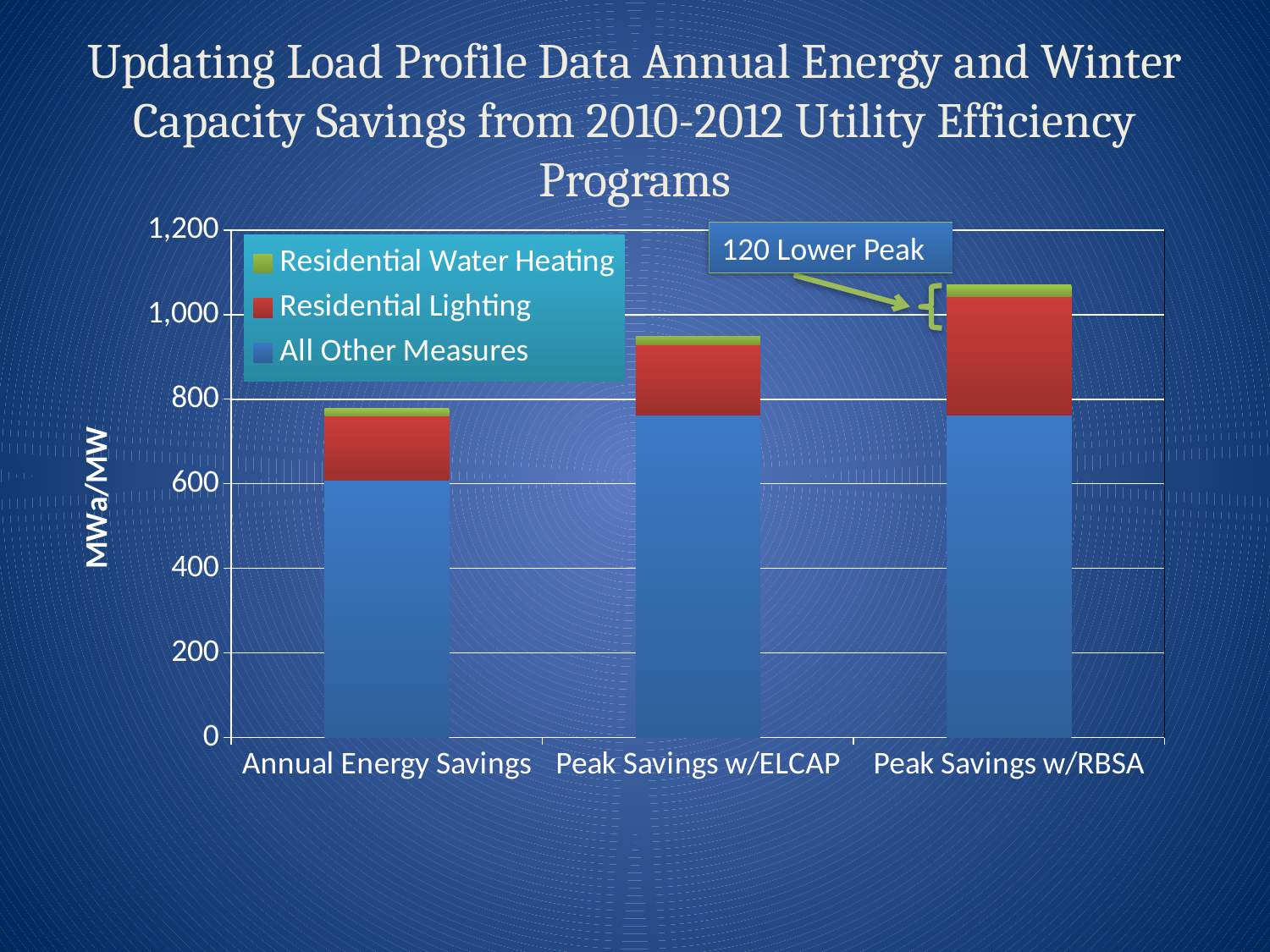
Is the total stacked value for Peak Savings w/ELCAP greater or less than 1,000? less What does the callout box above the Peak Savings w/RBSA bar say? 120 Lower Peak Is the total stacked value for Annual Energy Savings greater or less than 800? less What kind of chart is shown on the slide? Stacked bar chart Which category has the tallest stacked bar? Peak Savings w/RBSA How many series does the chart's legend list? 3 What is the label on the chart's vertical axis? MWa/MW Which category has the shortest stacked bar? Annual Energy Savings Which is larger, the total stacked bar for Peak Savings w/ELCAP or for Annual Energy Savings? Peak Savings w/ELCAP How many categories are shown on the x axis of the chart? 3 Is the total stacked value for Peak Savings w/RBSA greater or less than 1,000? greater